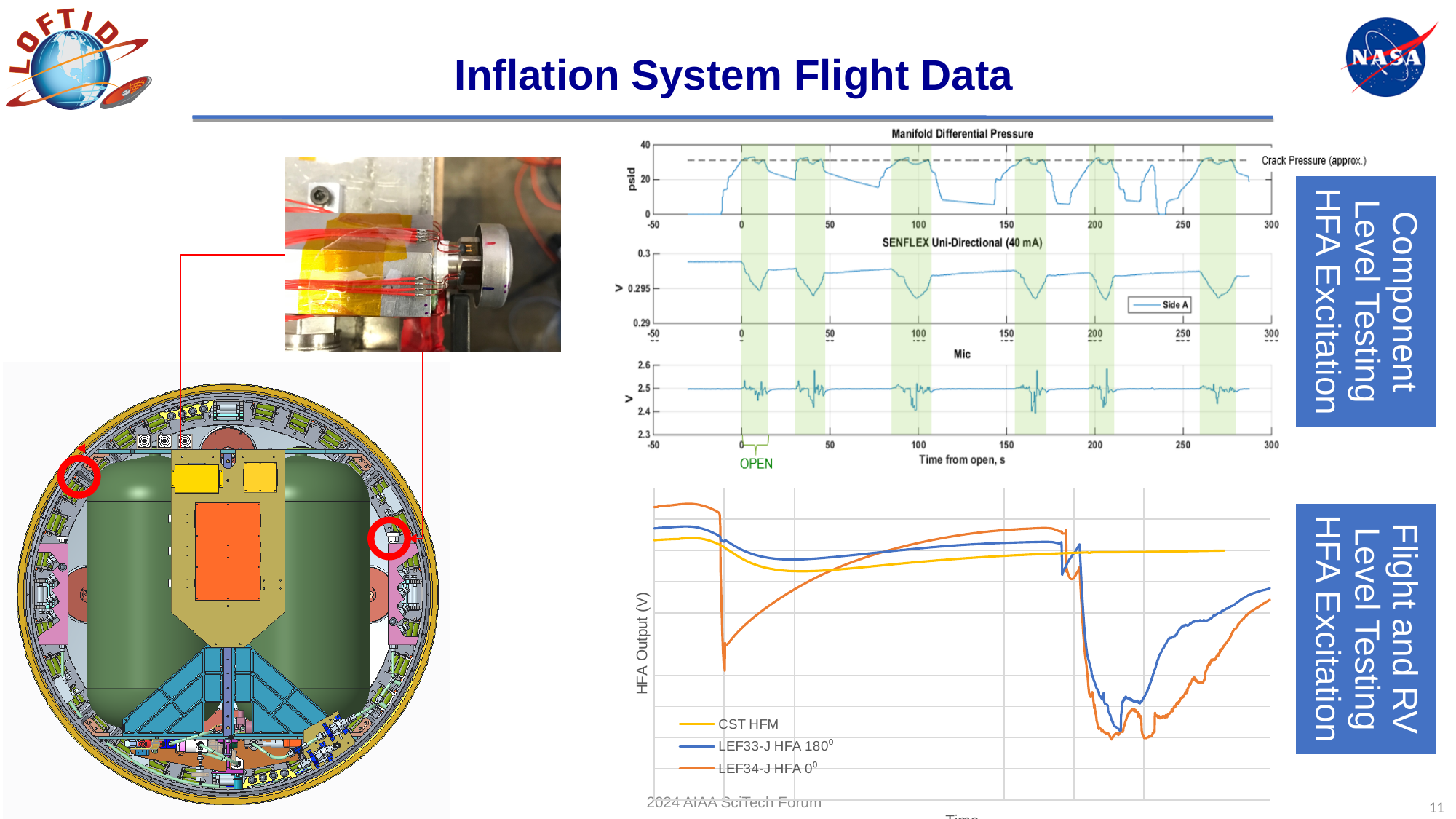
In the 'Manifold Differential Pressure' chart, is the value at 130 s greater or less than 20? less In the 'Manifold Differential Pressure' chart, is the value at 100 s greater or less than 20? greater What is the y-axis unit of the 'Manifold Differential Pressure' chart? psid What is the x-axis label shared by the three stacked charts on the upper right? Time from open, s In the bottom 'HFA Output (V)' chart, which series is drawn in yellow? CST HFM How many series does the legend of the bottom 'HFA Output (V)' chart list? 3 In the 'Mic' chart, is the value at 0 s greater or less than 2.4? greater What kind of chart is the bottom chart labelled 'HFA Output (V)'? line chart